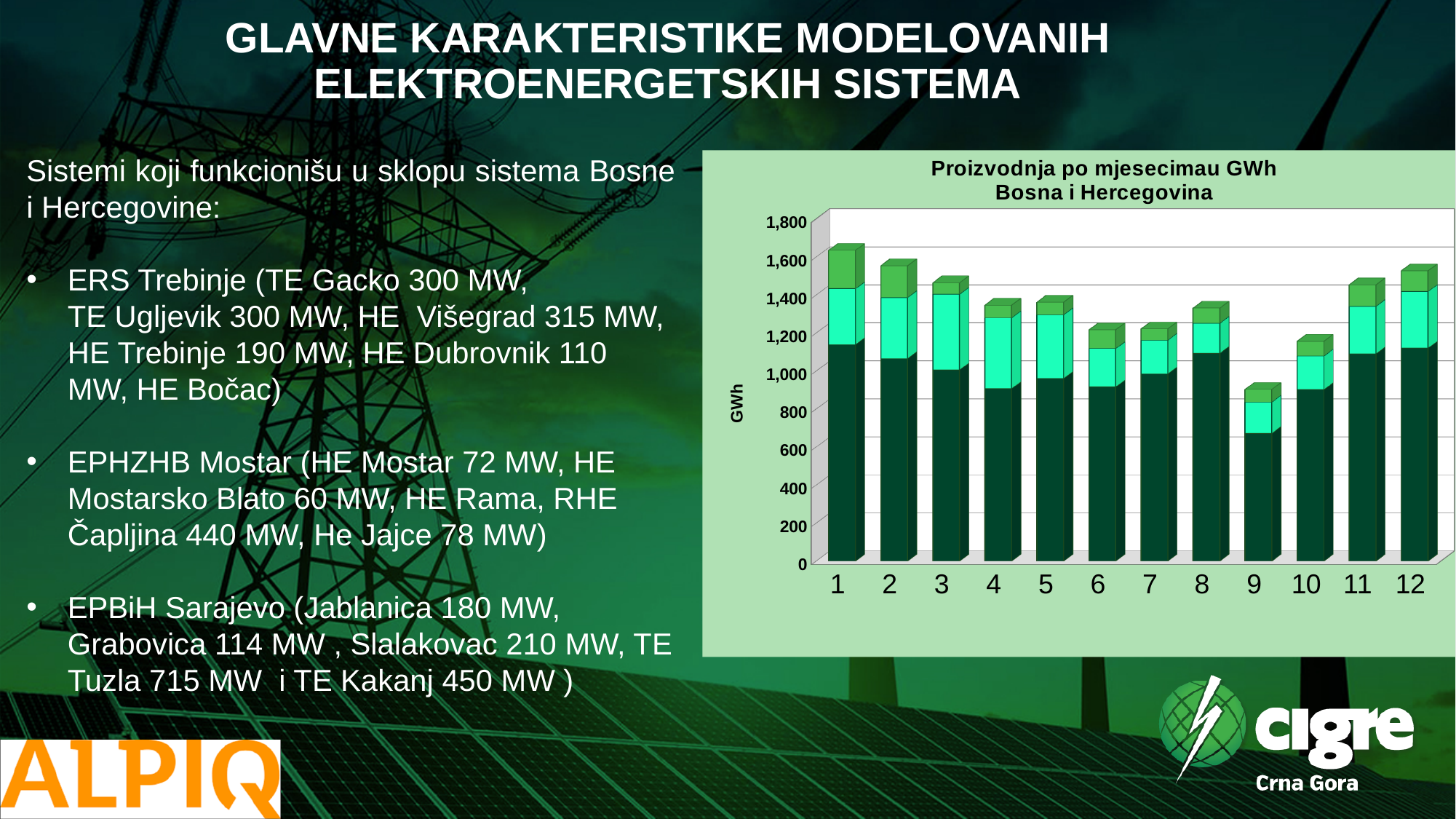
Which month has a larger total production, month 2 or month 4? 2 Is the total value for month 12 greater or less than 1,400 GWh? greater Which month has the lowest total production in the chart? 9 What kind of chart is shown on the slide? bar chart Is the total value for month 1 greater or less than 1,400 GWh? greater Do the total values rise or fall from month 9 to month 12? rise Which month has the highest total production in the chart? 1 How many months (categories) are plotted on the x axis of the chart? 12 Is the total value for month 10 greater or less than 1,400 GWh? less What is the title of the chart? Proizvodnja po mjesecimau GWh Bosna i Hercegovina What is the label on the vertical axis of the chart? GWh